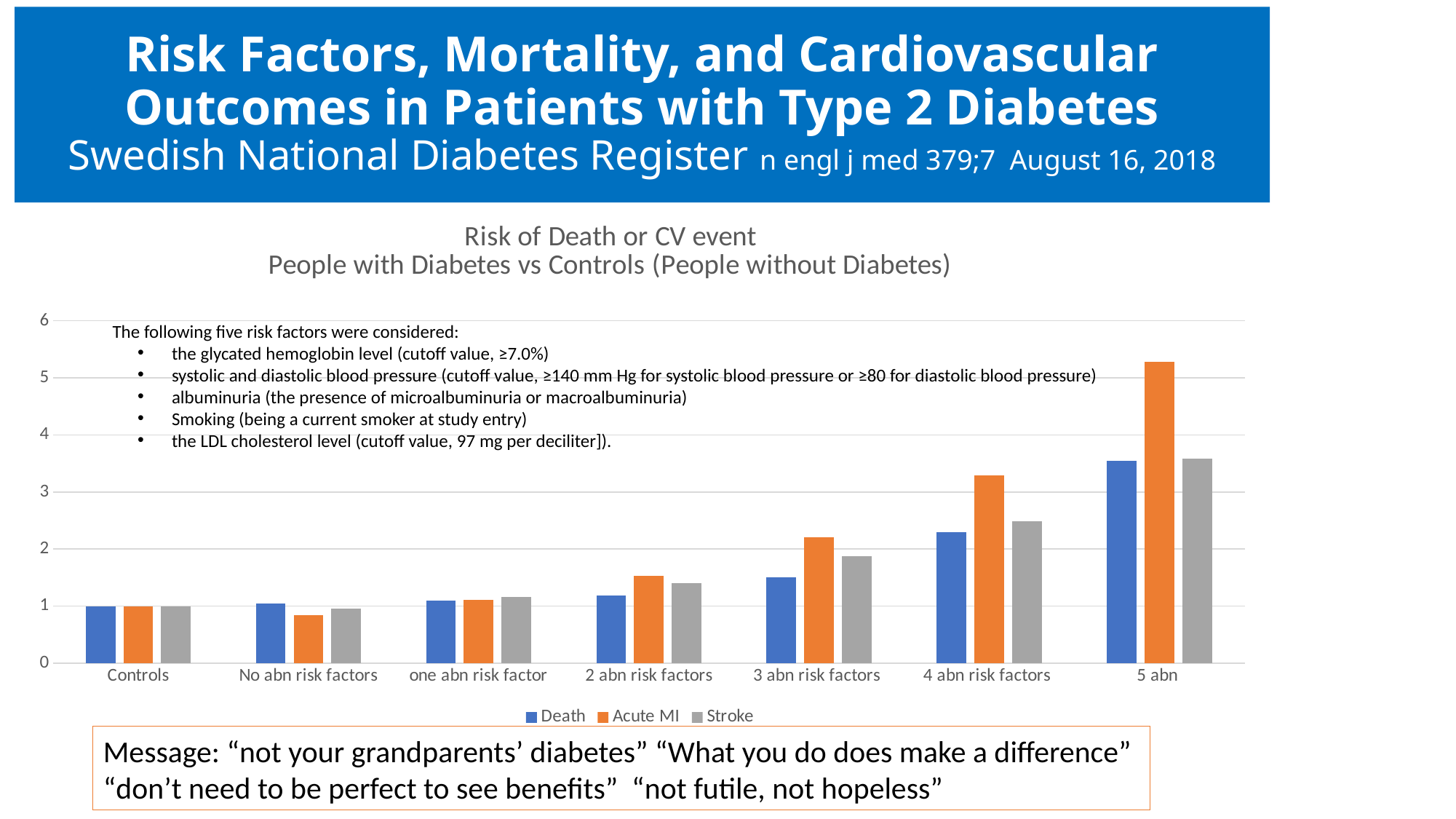
How many series does the legend list? 3 Is the Acute MI value for No abn risk factors greater or less than 1? less For 4 abn risk factors, which is larger: Acute MI or Stroke? Acute MI What kind of chart is shown on the slide? bar chart What is the value for Death in the Controls category? 1 Do the Death values rise or fall moving from Controls to 5 abn along the x axis? rise Which category has the lowest Acute MI value? No abn risk factors Which category has the highest Acute MI value? 5 abn Is the Acute MI value for 5 abn greater or less than 5? greater How many categories are shown along the x axis? 7 Is the Stroke value for 3 abn risk factors greater or less than 2? less